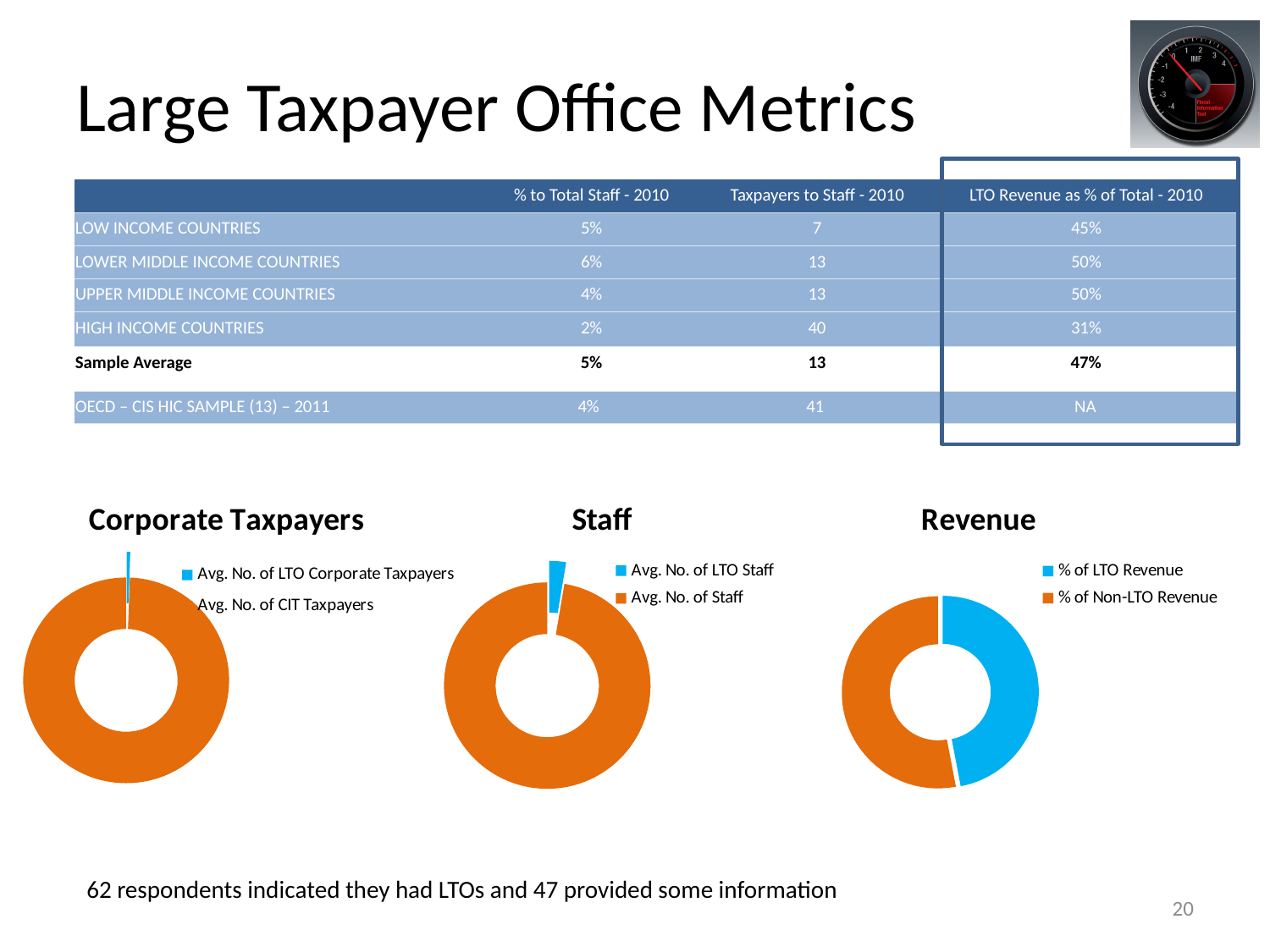
How many charts are shown on the slide? 3 In the "Corporate Taxpayers" chart, which slice is larger: "Avg. No. of LTO Corporate Taxpayers" or "Avg. No. of CIT Taxpayers"? Avg. No. of CIT Taxpayers How many entries does the legend of the "Staff" chart list? 2 In the "Corporate Taxpayers" chart, which slice is the largest? Avg. No. of CIT Taxpayers What colour is the "Avg. No. of LTO Staff" slice in the "Staff" chart? Blue In the "Staff" chart, which slice is larger: "Avg. No. of LTO Staff" or "Avg. No. of Staff"? Avg. No. of Staff In the "Revenue" chart, which slice is larger: "% of LTO Revenue" or "% of Non-LTO Revenue"? % of Non-LTO Revenue What are the two legend entries of the "Revenue" chart? % of LTO Revenue; % of Non-LTO Revenue How many slices does the "Revenue" chart have? 2 What kind of chart is the "Corporate Taxpayers" chart? Doughnut chart In the "Staff" chart, which slice is the smallest? Avg. No. of LTO Staff What kind of chart is the "Revenue" chart? Doughnut chart